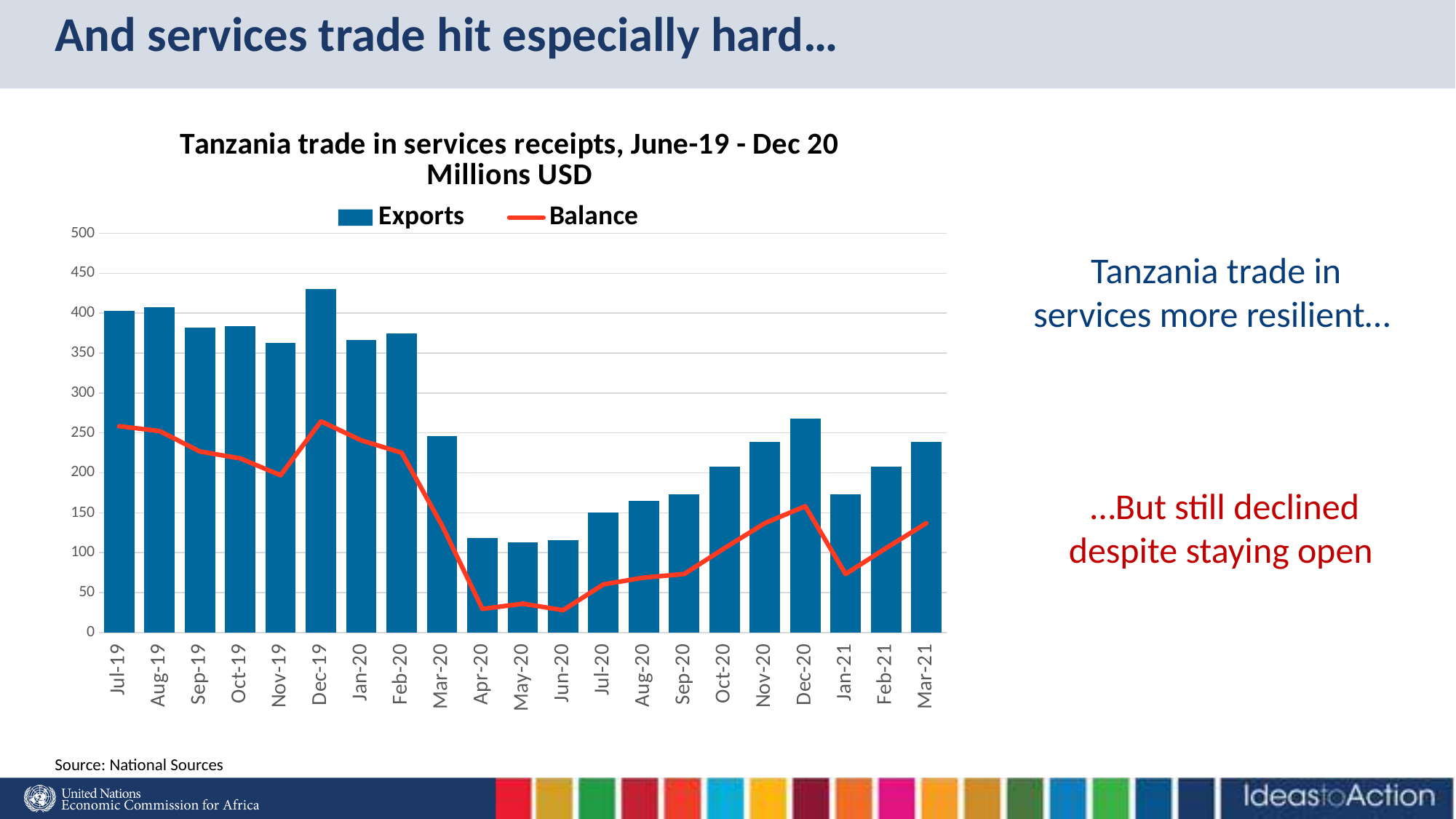
What kind of chart is used to show Exports? Bar chart How many months are plotted along the x axis of the chart? 21 In which month are Exports highest? Dec-19 Which month has higher Exports, Mar-20 or Apr-20? Mar-20 Is the Exports value for Dec-20 greater or less than 250? greater What are the two series shown in the chart legend? Exports and Balance How many series does the chart legend list? 2 Do Exports rise or fall from Apr-20 to Dec-20? rise Is the Exports value for Apr-20 greater or less than 150? less Which month has a higher Balance, Dec-20 or Jan-21? Dec-20 Is the Exports value for Dec-19 greater or less than 400? greater